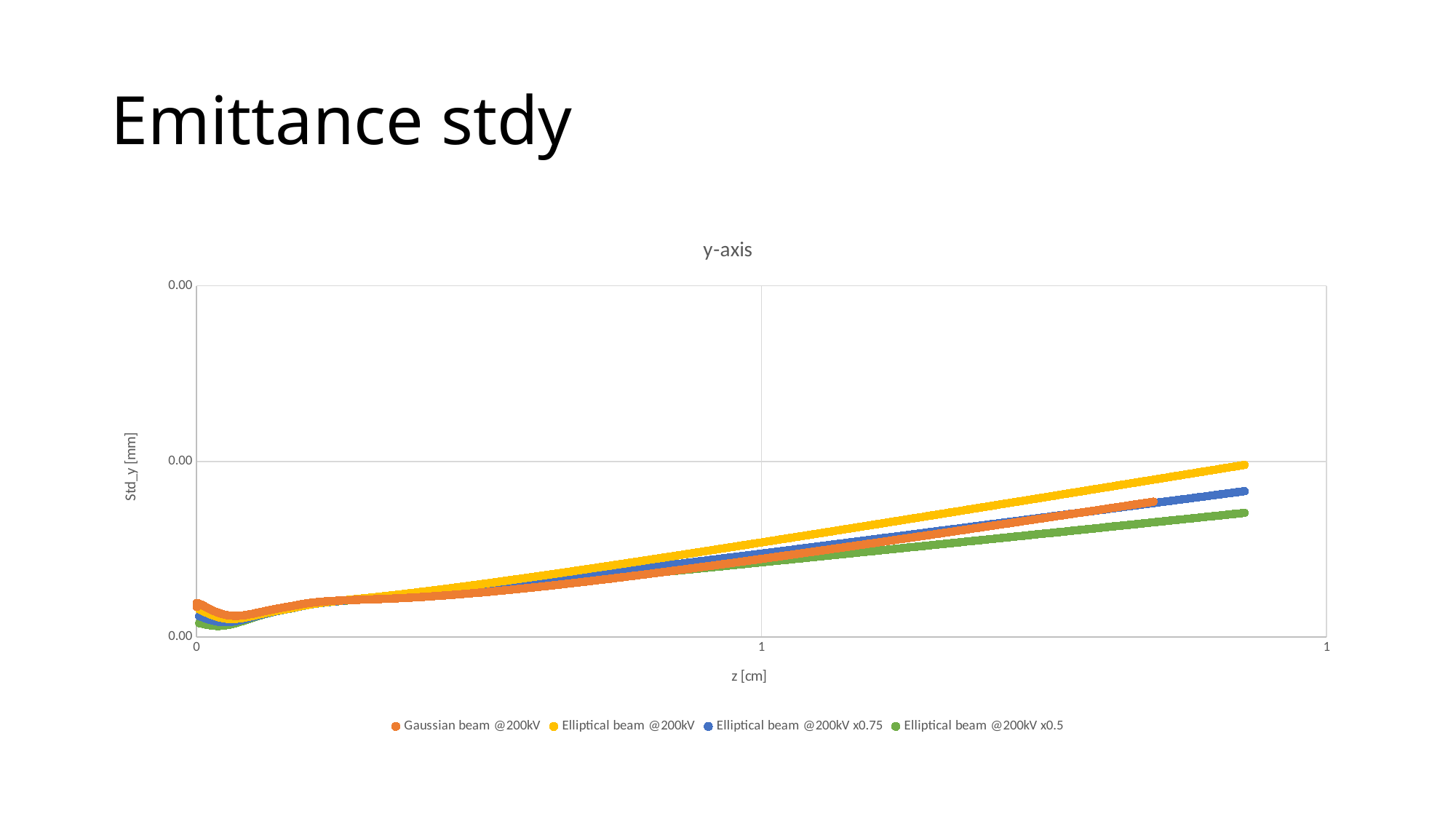
Which series reaches the highest Std_y value at the right end of the chart? Elliptical beam @200kV What kind of chart is shown on the slide? scatter chart Does the Std_y value for the Elliptical beam @200kV series generally rise or fall as z increases? rise At the right end of the chart, which series has the larger Std_y value: Elliptical beam @200kV x0.75 or Elliptical beam @200kV x0.5? Elliptical beam @200kV x0.75 At the right end of the chart, which series has the larger Std_y value: Elliptical beam @200kV or Gaussian beam @200kV? Elliptical beam @200kV Which series has the lowest Std_y value at the right end of the chart? Elliptical beam @200kV x0.5 What is the label of the horizontal axis of the chart? z [cm] Does the Std_y value for the Elliptical beam @200kV x0.5 series rise or fall over the right half of the chart? rise What is the title of the chart? y-axis How many series does the chart legend list? 4